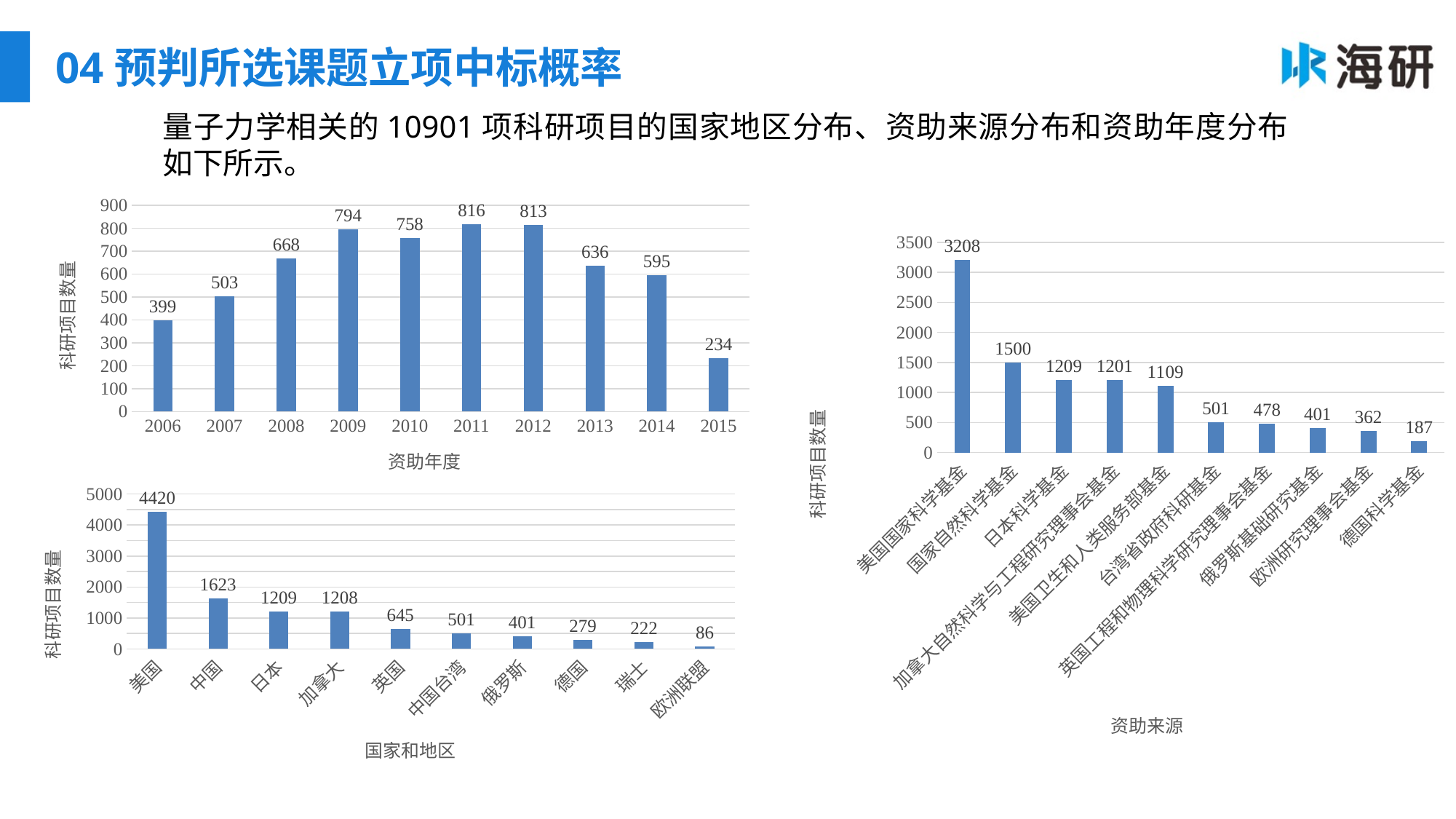
In the bottom-left chart (国家和地区), which category has the lowest value? 欧洲联盟 What type of chart is the right chart (资助来源)? Bar chart In the top-left chart (资助年度), how many years are shown on the x axis? 10 In the top-left chart (资助年度), which year has the highest value? 2011 In the right chart (资助来源), what is the value for 国家自然科学基金? 1500 In the bottom-left chart (国家和地区), which category has the highest value? 美国 In the bottom-left chart (国家和地区), what is the value for 中国? 1623 In the top-left chart (资助年度), what is the difference between the values for 2008 and 2007? 165 In the top-left chart (资助年度), what is the value for 2009? 794 In the bottom-left chart (国家和地区), which is larger, the value for 英国 or the value for 中国台湾? 英国 In the top-left chart (资助年度), which year has the lowest value? 2015 In the right chart (资助来源), what is the difference between the values for 美国国家科学基金 and 德国科学基金? 3021